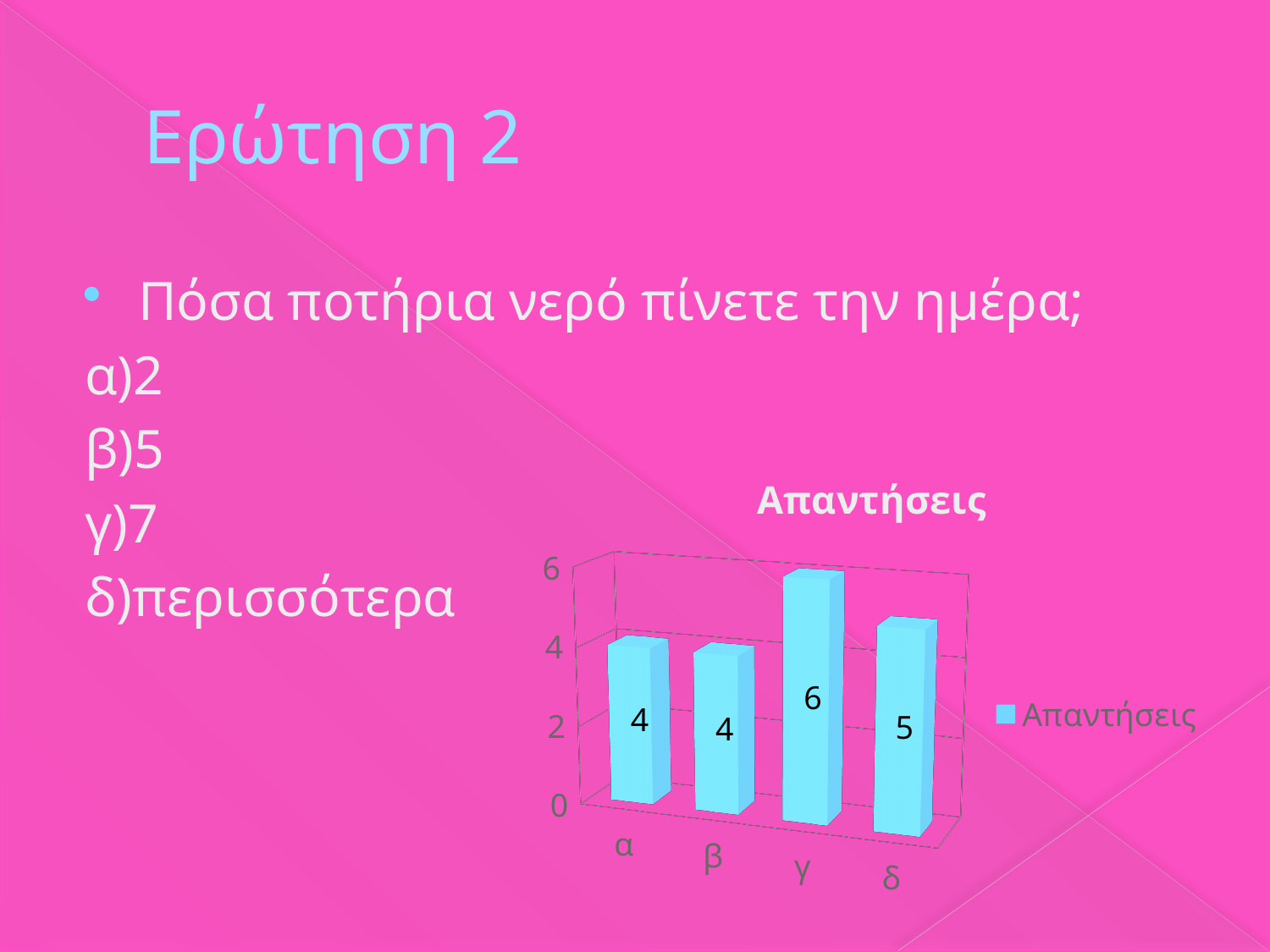
What is the title of the chart? Απαντήσεις Which is larger, the value for δ or the value for β? δ Which category has the highest value? γ What is the value for category γ? 6 How many categories are shown on the x axis? 4 What is the value for category δ? 5 What is the difference between the values for γ and δ? 1 What is the value for category α? 4 What is the total of all four bar values? 19 What kind of chart is shown? bar chart How many series does the legend list? 1 What is the difference between the values for γ and α? 2